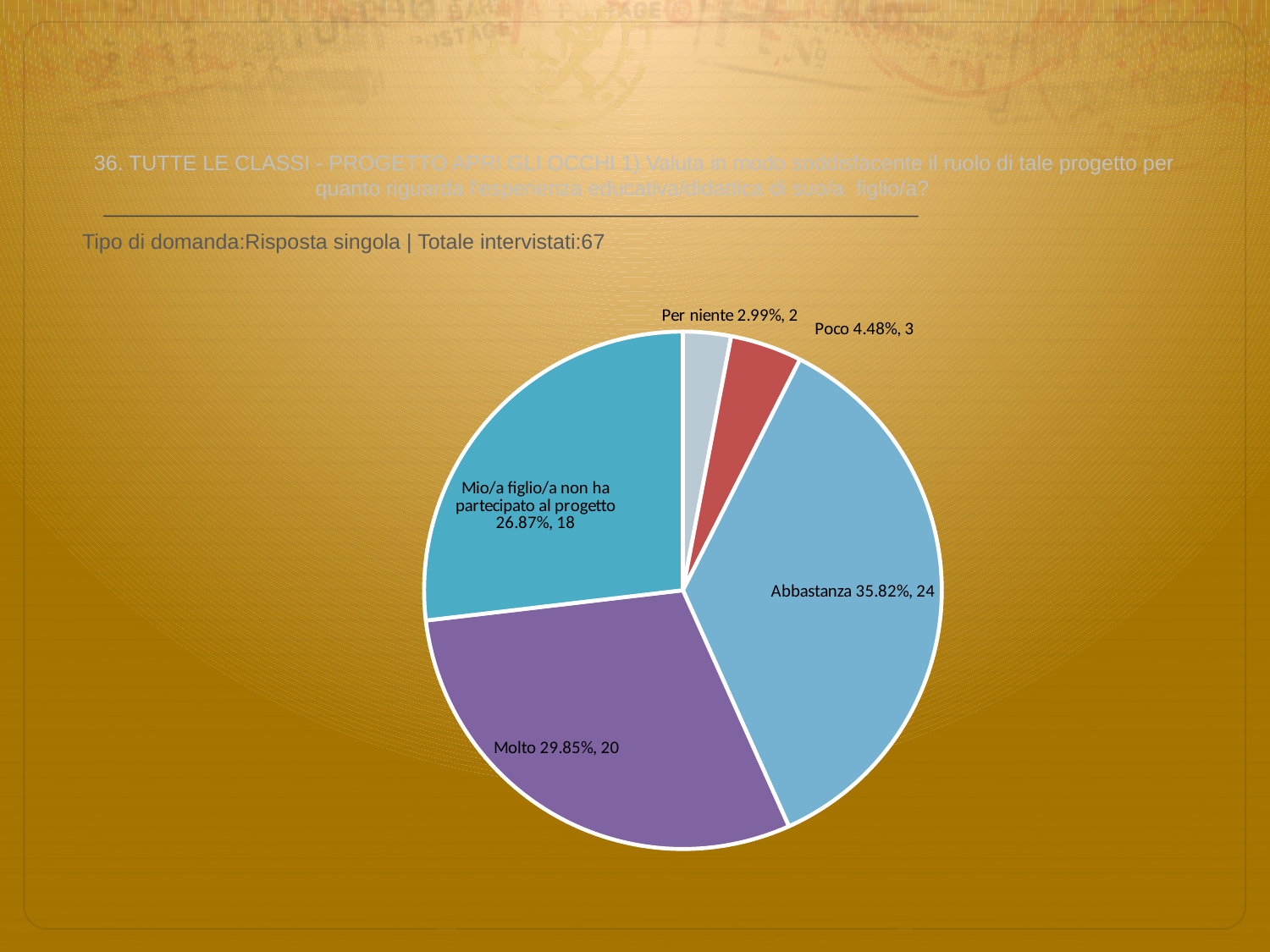
How many respondents chose Poco? 3 What is the difference in respondent count between Abbastanza and Molto? 4 What kind of chart is shown on the slide? pie chart What percentage is shown for the slice 'Mio/a figlio/a non ha partecipato al progetto'? 26.87% What is the total number of respondents stated on the slide? 67 What percentage is shown for the Abbastanza slice? 35.82% What percentage is shown for the Per niente slice? 2.99% Which category has the largest slice of the pie? Abbastanza How many slices does the pie chart have? 5 How many respondents chose Molto? 20 Which category has the smallest slice of the pie? Per niente Which slice is larger, Molto or 'Mio/a figlio/a non ha partecipato al progetto'? Molto